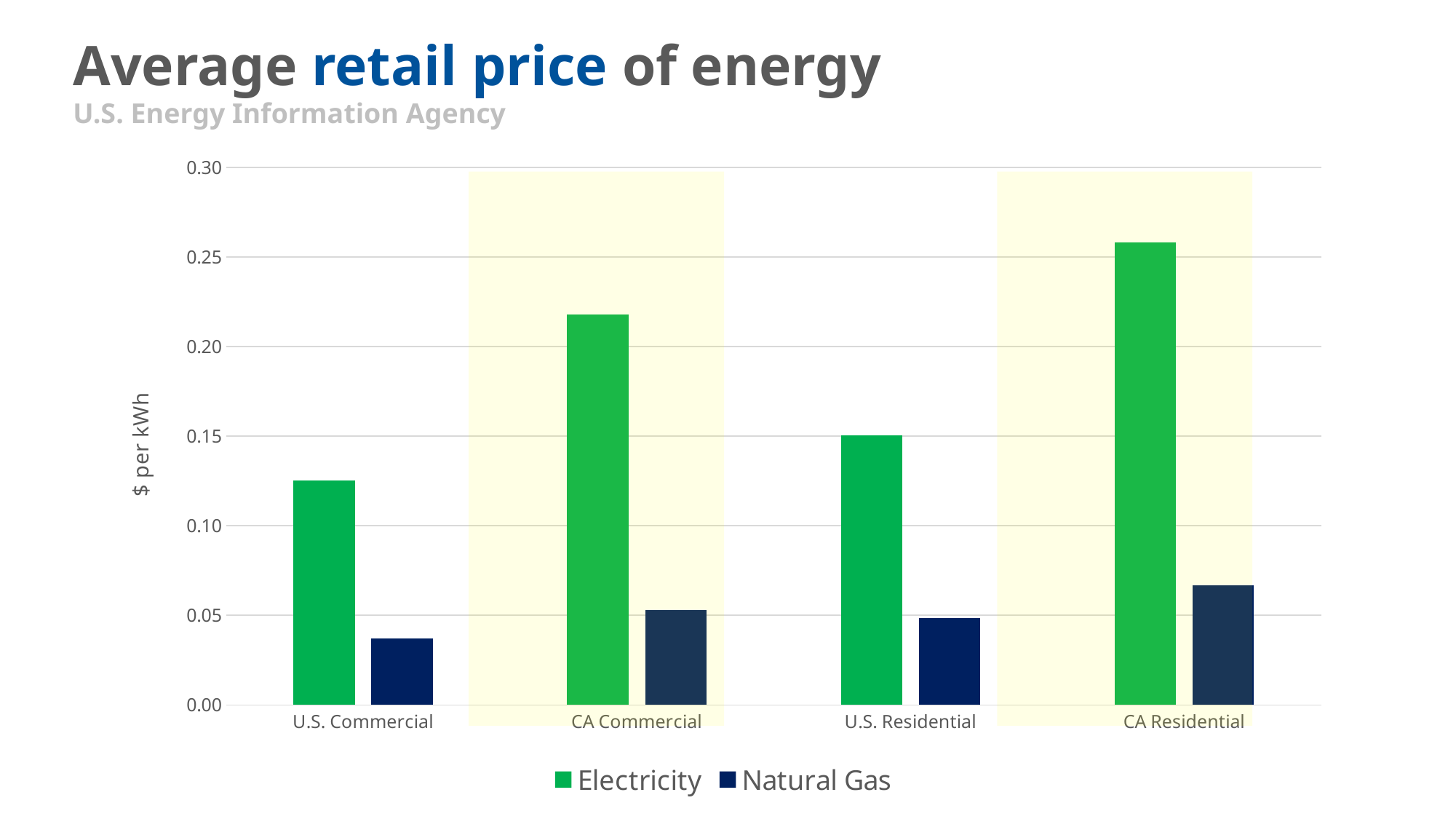
How many series does the legend list? 2 What is the label on the y axis? $ per kWh Which is larger: the Electricity value for CA Commercial or the Electricity value for U.S. Residential? CA Commercial What kind of chart is shown on the slide? bar chart Is the Natural Gas value for U.S. Commercial greater or less than 0.05? less Which category has the lowest Natural Gas price? U.S. Commercial Is the Electricity value for U.S. Commercial greater or less than 0.10? greater Which category has the highest Natural Gas price? CA Residential Is the Electricity value for CA Commercial greater or less than 0.20? greater How many categories are shown on the x axis? 4 Which category has the highest Electricity price? CA Residential Which category has the lowest Electricity price? U.S. Commercial